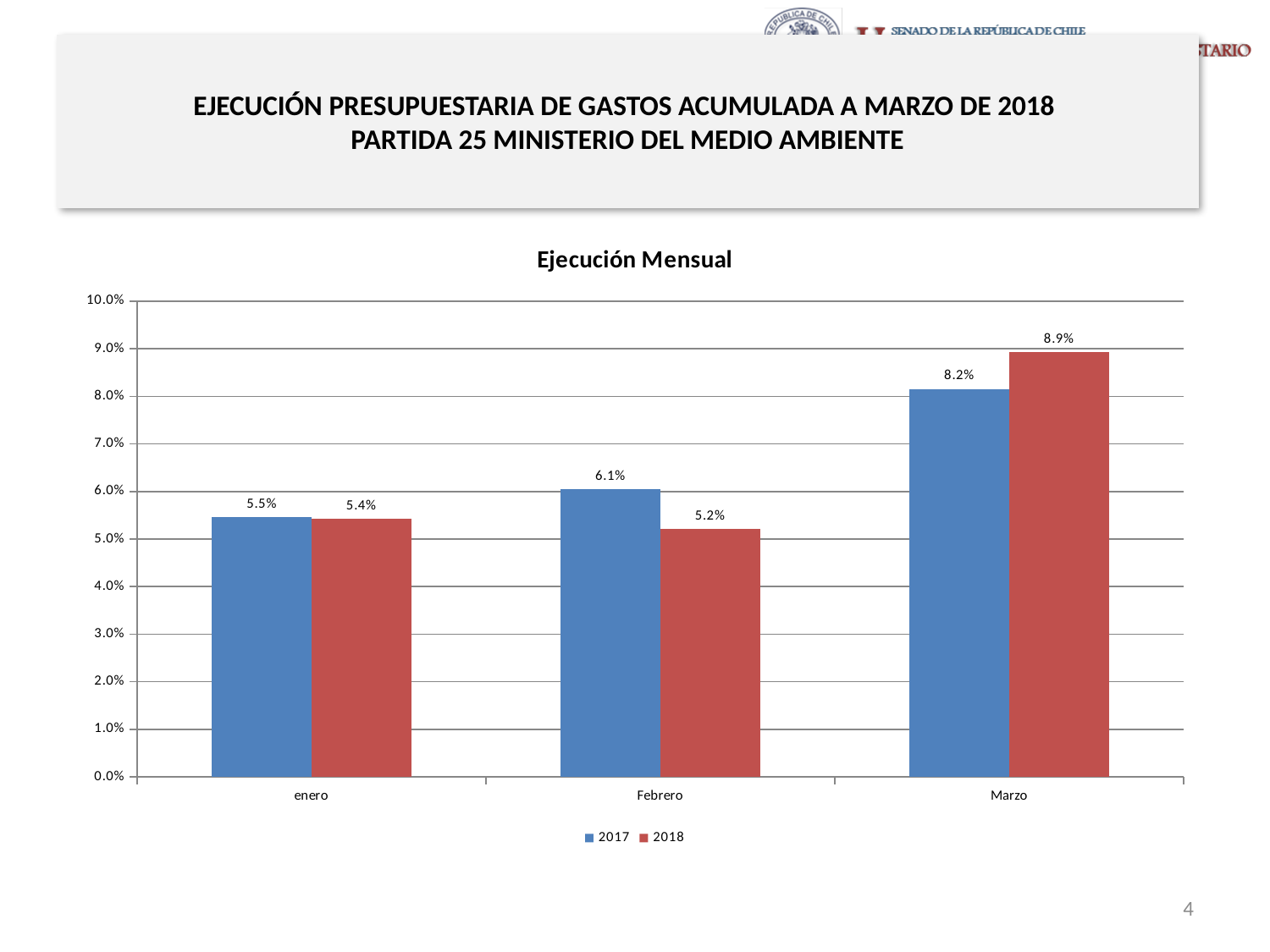
What is the value for 2017 in Marzo? 8.2% Which month has the highest value for 2018? Marzo How many months are shown on the x axis? 3 How many series does the legend list? 2 Which month has the lowest value for 2017? enero What kind of chart is shown? bar chart Is the value for 2018 in Marzo greater or less than 8.0%? greater What is the title of the chart? Ejecución Mensual What is the value for 2018 in enero? 5.4% What is the difference between the 2018 and 2017 values in Marzo? 0.7% What is the value for 2018 in Febrero? 5.2% In Febrero, which series has the larger value, 2017 or 2018? 2017